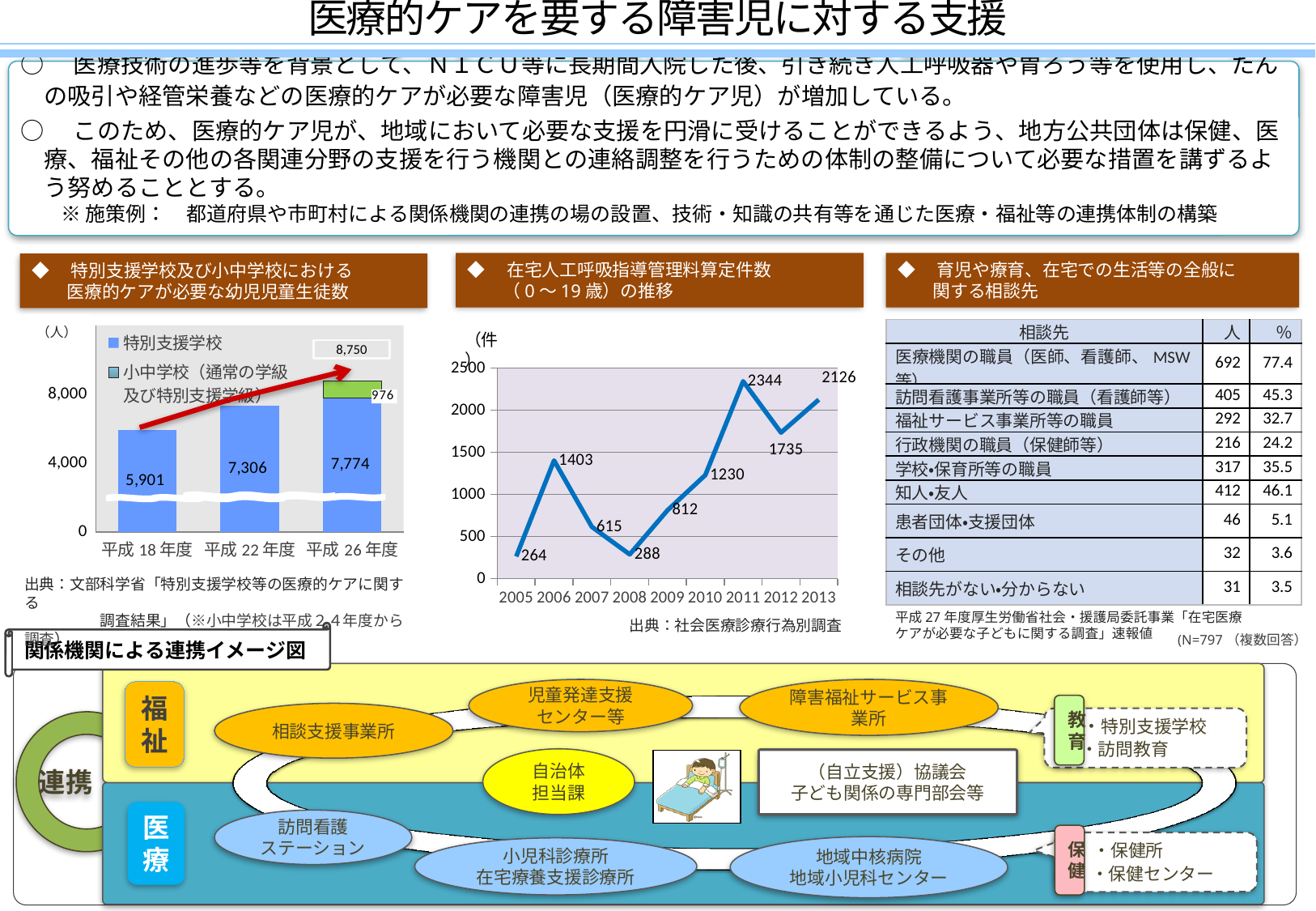
How many series does the legend of the bar chart on the left list? 2 In the bar chart on the left, what is the total of the stacked bar for 平成26年度? 8,750 In the bar chart on the left, how much larger is the 特別支援学校 value in 平成26年度 than in 平成18年度? 1,873 In the bar chart on the left, what is the value for 特別支援学校 in 平成22年度? 7,306 In the middle line chart, which year has the highest value? 2011 What kind of chart is the middle chart titled 在宅人工呼吸指導管理料算定件数（0～19歳）の推移? line chart In the middle line chart, which is larger, the value for 2012 or the value for 2013? 2013 In the bar chart on the left, what is the value for 小中学校 in 平成26年度? 976 In the middle line chart, what is the value for 2008? 288 In the middle line chart, which year has the lowest value? 2005 Do the 特別支援学校 values in the bar chart on the left rise or fall from 平成18年度 to 平成26年度? rise In the middle line chart, what is the difference between the values for 2011 and 2010? 1114